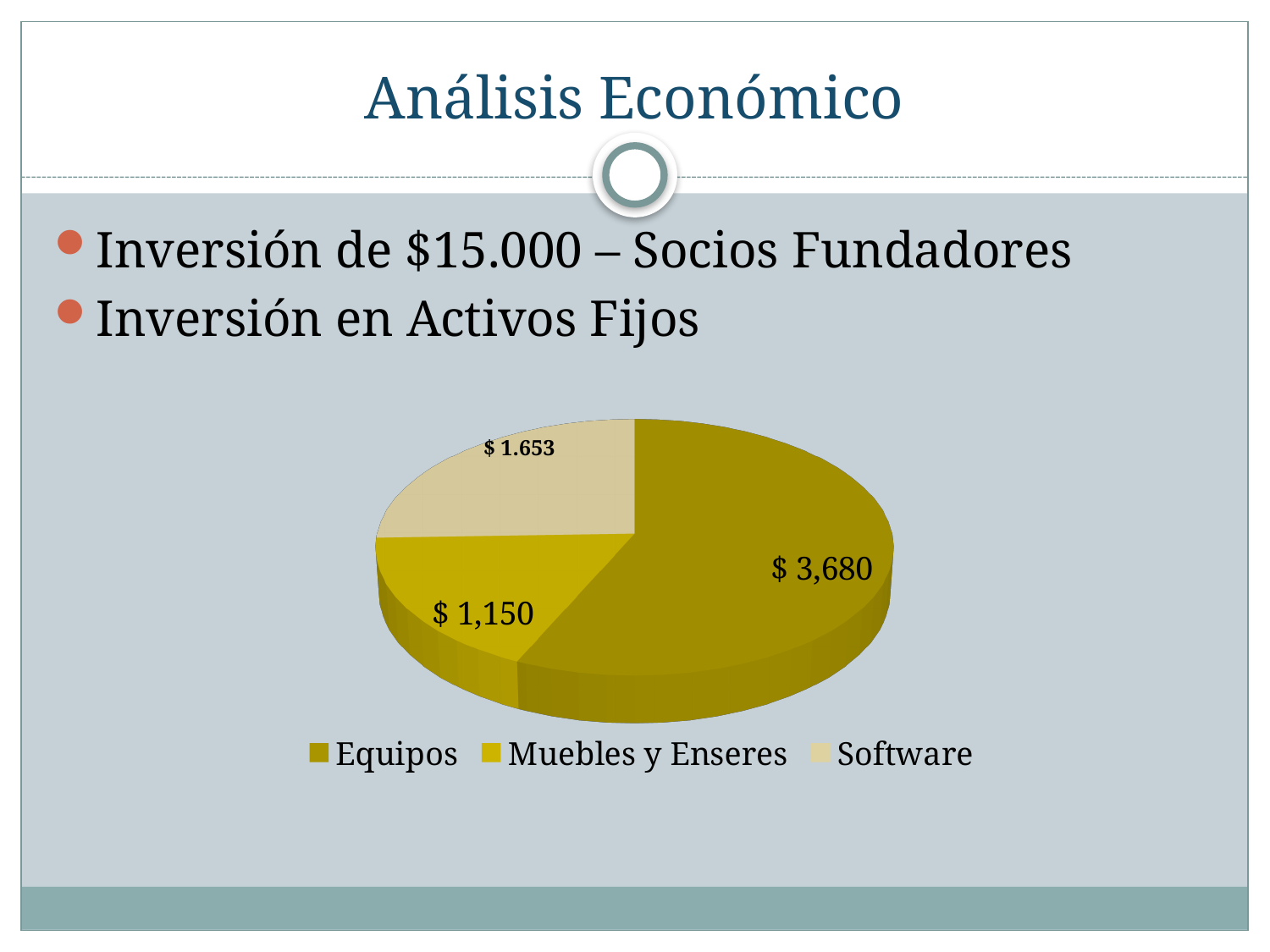
Which is larger, the Equipos slice or the Software slice? Equipos What is the difference between the Equipos value and the Muebles y Enseres value? $ 2,530 Which category has the smallest slice in the pie chart? Muebles y Enseres What kind of chart is shown on the slide? Pie chart What value is shown for the Software slice of the pie chart? $ 1.653 How many slices does the pie chart have? 3 What value is shown for the Muebles y Enseres slice of the pie chart? $ 1,150 How many entries does the chart legend list? 3 What value is shown for the Equipos slice of the pie chart? $ 3,680 What are the three categories listed in the chart legend? Equipos, Muebles y Enseres, Software Which category has the largest slice in the pie chart? Equipos Which is larger, the Software slice or the Muebles y Enseres slice? Software